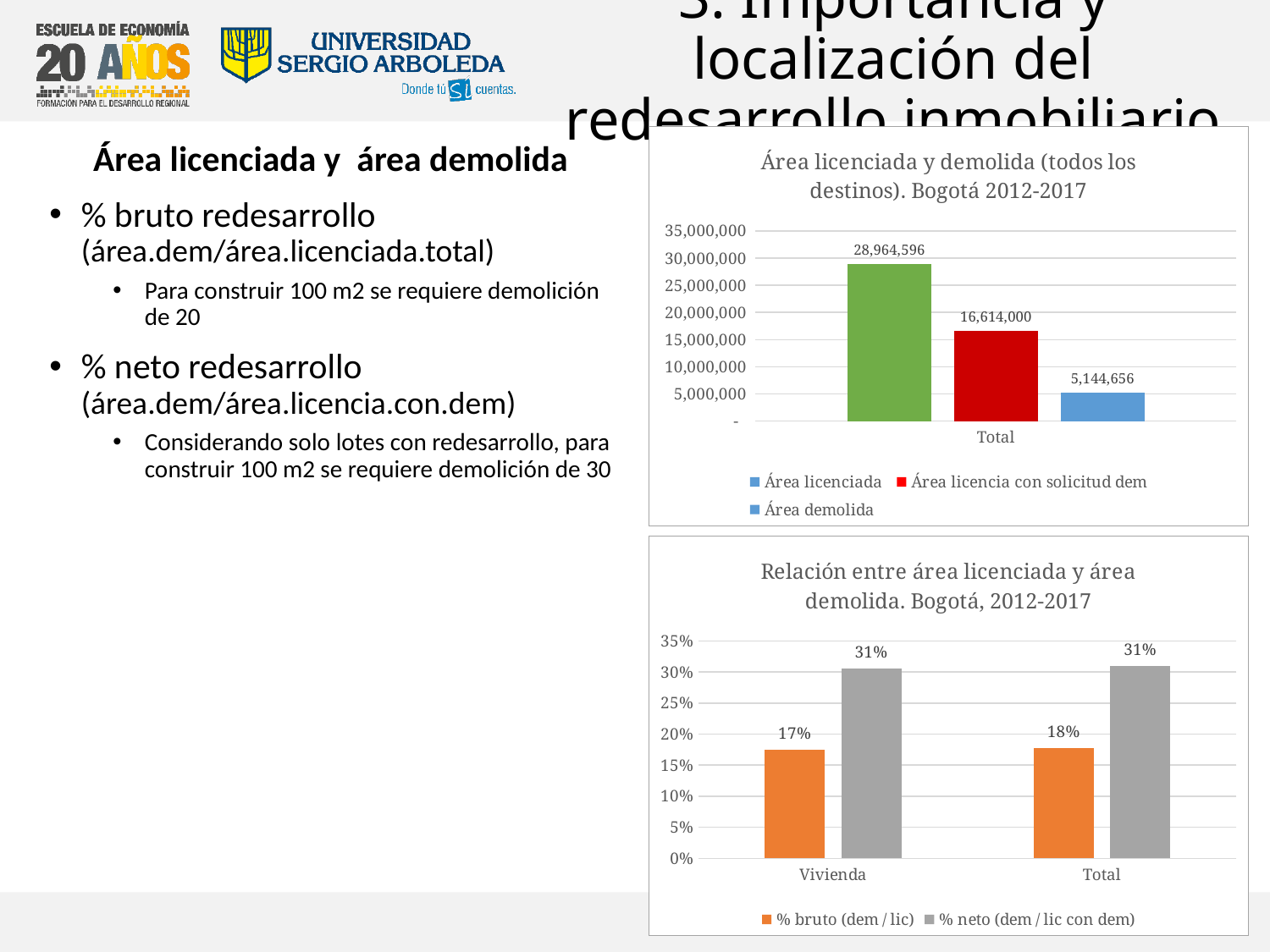
In the chart 'Relación entre área licenciada y área demolida. Bogotá, 2012-2017', how many categories are shown on the x axis? 2 In the chart 'Área licenciada y demolida (todos los destinos). Bogotá 2012-2017', how many series does the legend list? 3 In the chart 'Área licenciada y demolida (todos los destinos). Bogotá 2012-2017', what is the difference between Área licenciada and Área licencia con solicitud dem? 12,350,596 What kind of chart is 'Relación entre área licenciada y área demolida. Bogotá, 2012-2017'? Bar chart In the chart 'Área licenciada y demolida (todos los destinos). Bogotá 2012-2017', what is the value for Área demolida? 5,144,656 In the chart 'Área licenciada y demolida (todos los destinos). Bogotá 2012-2017', what is the value of the Área licenciada bar? 28,964,596 In the chart 'Relación entre área licenciada y área demolida. Bogotá, 2012-2017', what is the % bruto (dem / lic) value for Vivienda? 17% In the chart 'Relación entre área licenciada y área demolida. Bogotá, 2012-2017', what is the difference between % neto and % bruto for Total? 13% In the chart 'Área licenciada y demolida (todos los destinos). Bogotá 2012-2017', which series has the lowest value? Área demolida In the chart 'Relación entre área licenciada y área demolida. Bogotá, 2012-2017', which is larger for Vivienda: % bruto (dem / lic) or % neto (dem / lic con dem)? % neto (dem / lic con dem) In the chart 'Área licenciada y demolida (todos los destinos). Bogotá 2012-2017', what is the value for Área licencia con solicitud dem? 16,614,000 In the chart 'Relación entre área licenciada y área demolida. Bogotá, 2012-2017', what is the % neto (dem / lic con dem) value for Total? 31%